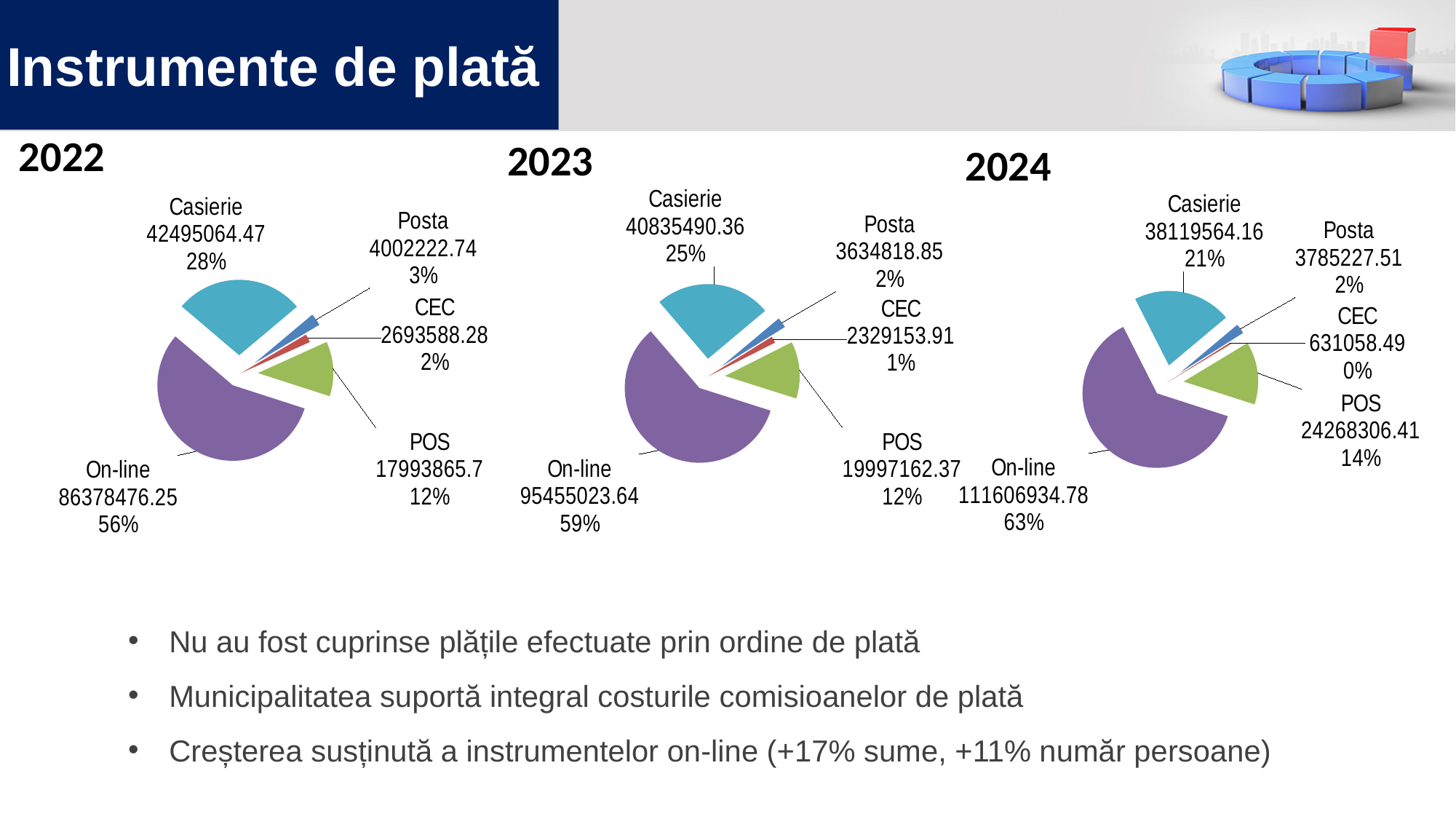
How many pie charts are shown on the slide? 3 In the 2024 chart, which category has the largest slice? On-line In the 2024 chart, what is the difference between the On-line value and the Casierie value? 73487370.62 In the 2022 chart, what is the value for On-line? 86378476.25 How many categories are shown in the 2024 pie chart? 5 In the 2023 chart, which category has the smallest slice? CEC In the 2023 chart, what share of the pie does On-line represent? 59% In the 2023 chart, what is the value for POS? 19997162.37 In the 2022 chart, what share of the pie does Casierie represent? 28% What type of chart is used for the 2022 data? pie chart In the 2022 chart, which is larger, the value for Posta or the value for CEC? Posta In the 2024 chart, what is the value for CEC? 631058.49